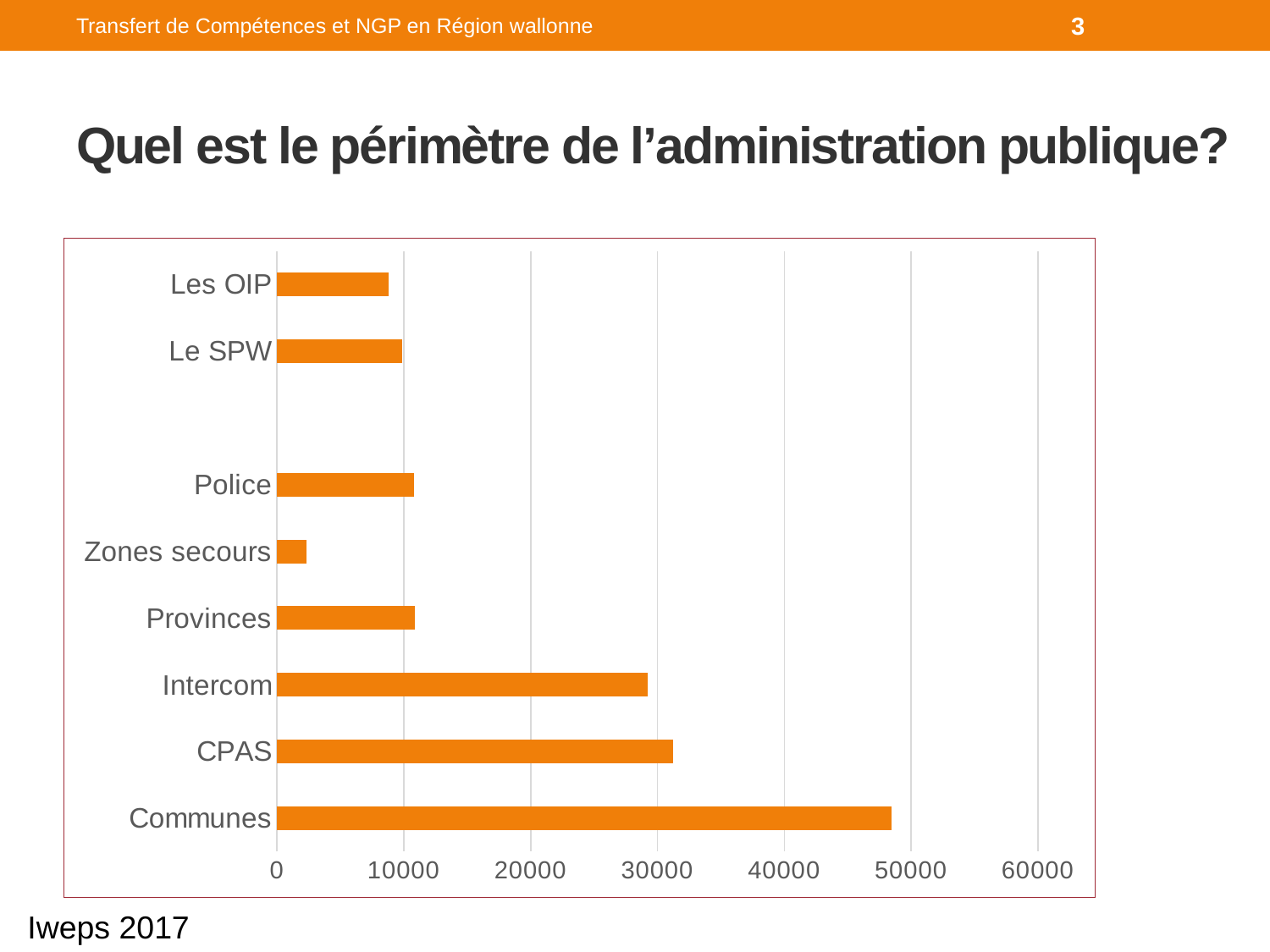
Which has a larger value, Intercom or Police? Intercom Which category has the highest value? Communes Which category has the lowest value? Zones secours Is the value for Communes greater or less than 40000? greater How many labelled categories are plotted in the chart? 8 Is the value for Intercom greater or less than 20000? greater Is the value for Communes greater or less than 50000? less What is the highest value shown on the horizontal axis? 60000 What kind of chart is shown on the slide? bar chart